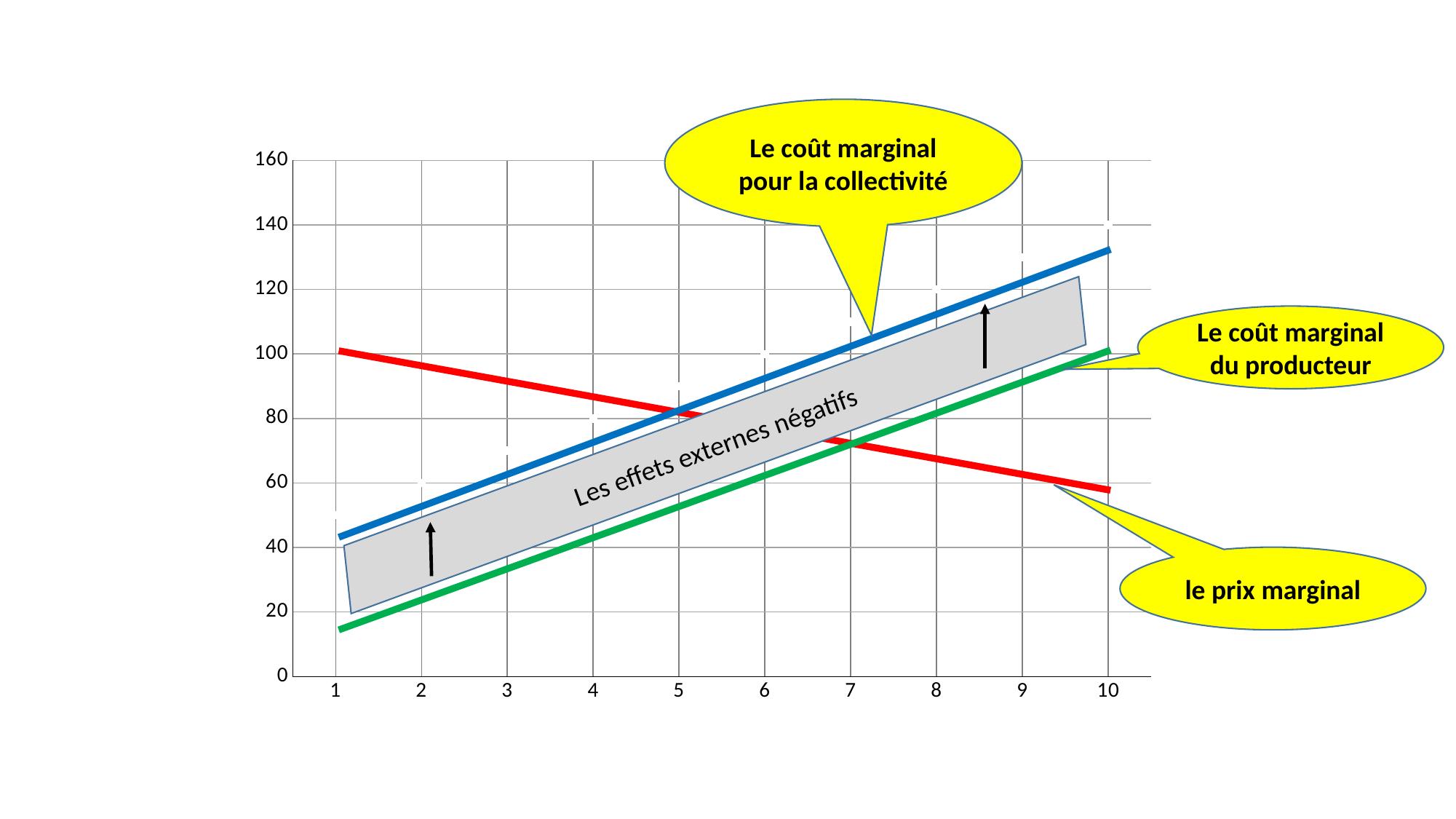
At x = 1, which is larger: 'le prix marginal' or 'Le coût marginal pour la collectivité'? le prix marginal Is the value of 'le prix marginal' at x = 1 greater or less than 80? greater Is the value of 'Le coût marginal pour la collectivité' at x = 10 greater or less than 120? greater At x = 10, which is larger: 'le prix marginal' or 'Le coût marginal du producteur'? Le coût marginal du producteur Does the line labelled 'le prix marginal' rise or fall as x increases from 1 to 10? fall Does the line labelled 'Le coût marginal pour la collectivité' rise or fall as x increases from 1 to 10? rise How many lines are plotted on the chart? 3 Is the value of 'Le coût marginal du producteur' at x = 1 greater or less than 20? less How many points are marked along the x axis? 10 What kind of chart is shown on the slide? line chart Does the line labelled 'Le coût marginal du producteur' rise or fall along the x axis? rise What colour is the line labelled 'le prix marginal'? red